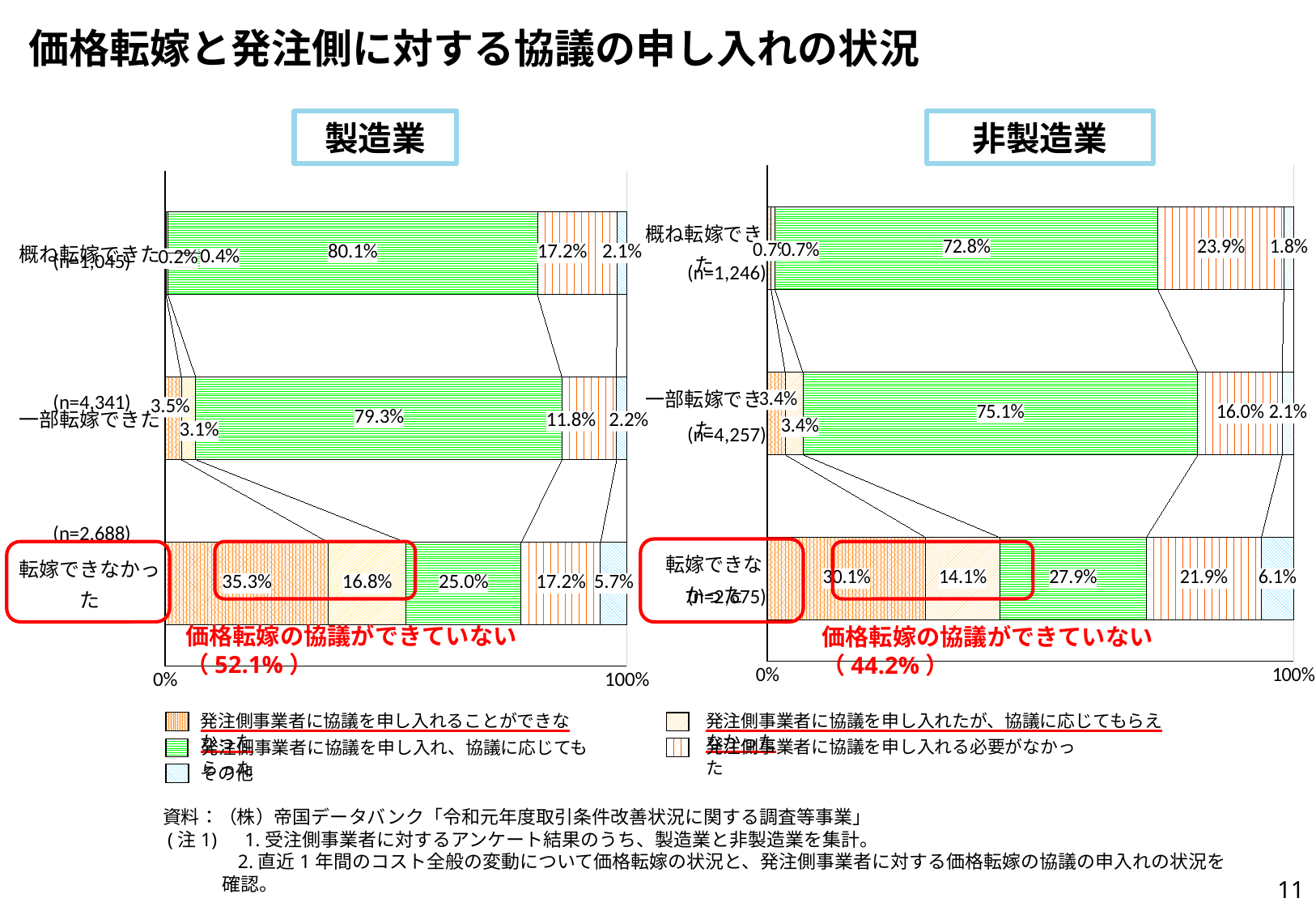
In the 非製造業 chart, what percentage of the 転嫁できなかった group answered 発注側事業者に協議を申し入れることができなかった? 30.1% What is the difference between the 製造業 and 非製造業 red-highlighted totals for 価格転嫁の協議ができていない (52.1% vs 44.2%)? 7.9% In the 製造業 chart, which category has the highest share for 発注側事業者に協議を申し入れ、協議に応じてもらえた (green)? 概ね転嫁できた How many series does the legend list for the charts? 5 In the 非製造業 chart, what percentage of the 一部転嫁できた group answered 発注側事業者に協議を申し入れる必要がなかった? 16.0% How many categories (bars) does the 製造業 chart show? 3 In the 製造業 chart, what percentage of the 概ね転嫁できた group answered 発注側事業者に協議を申し入れ、協議に応じてもらえた (green)? 80.1% What is the sample size (n) for the 転嫁できなかった category in the 非製造業 chart? n=2,675 In the 転嫁できなかった category, is the green share (協議に応じてもらえた) larger in the 製造業 chart or the 非製造業 chart? 非製造業 In the 製造業 chart, what percentage of the 転嫁できなかった group answered 発注側事業者に協議を申し入れたが、協議に応じてもらえなかった? 16.8% In the 非製造業 chart, which category has the lowest share for その他? 概ね転嫁できた What kind of chart is used for 製造業 and 非製造業? Stacked bar chart